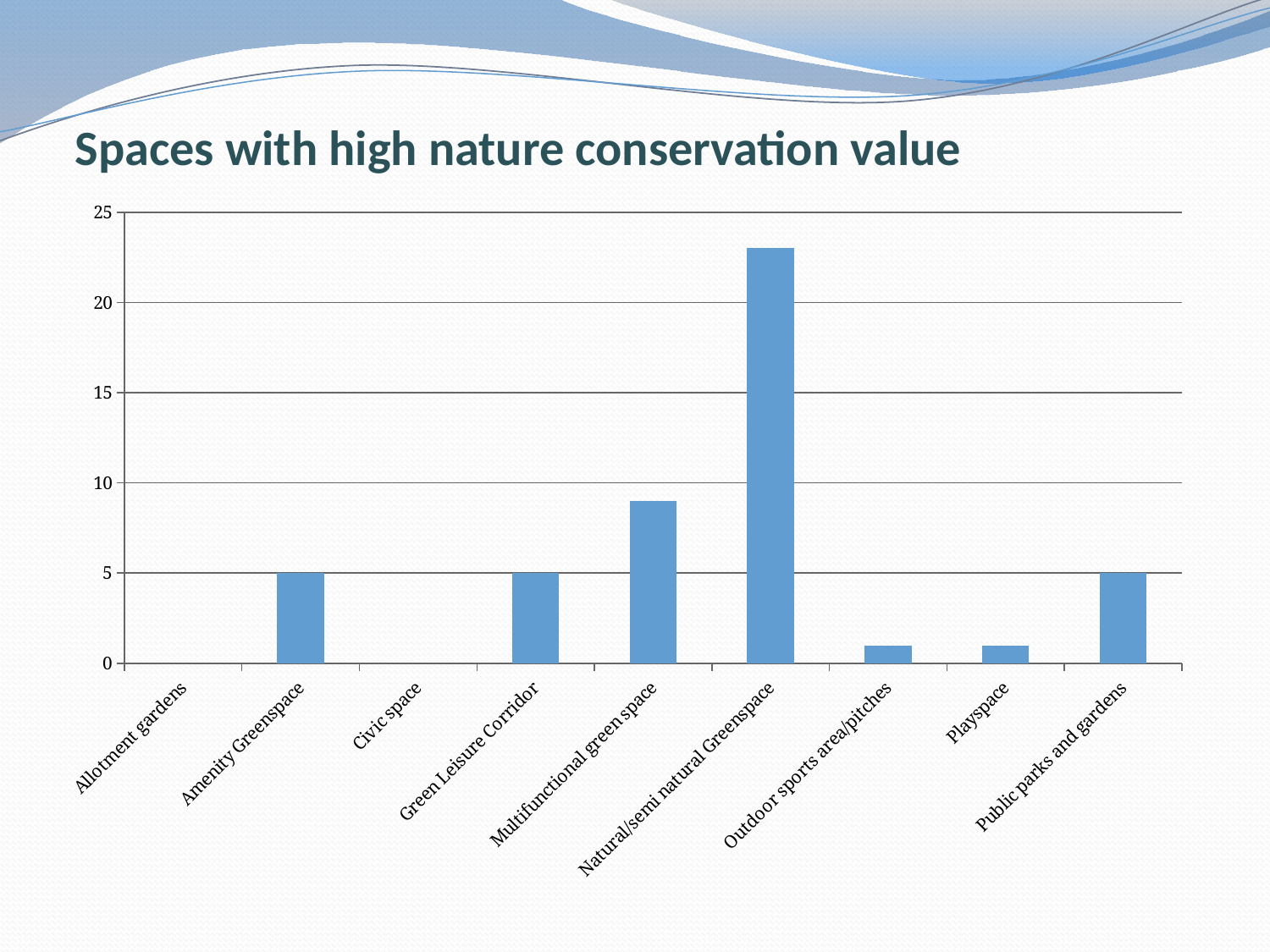
What is the value for Green Leisure Corridor? 5 What is the value for Civic space? 0 What is the value for Public parks and gardens? 5 Is the value for Outdoor sports area/pitches greater or less than 5? less How many categories are shown on the x axis? 9 Which category has the highest value? Natural/semi natural Greenspace Is the value for Natural/semi natural Greenspace greater or less than 20? greater Which is larger, the value for Multifunctional green space or the value for Amenity Greenspace? Multifunctional green space What kind of chart is shown on the slide? bar chart Is the value for Multifunctional green space greater or less than 10? less What is the value for Amenity Greenspace? 5 What is the title of the chart? Spaces with high nature conservation value